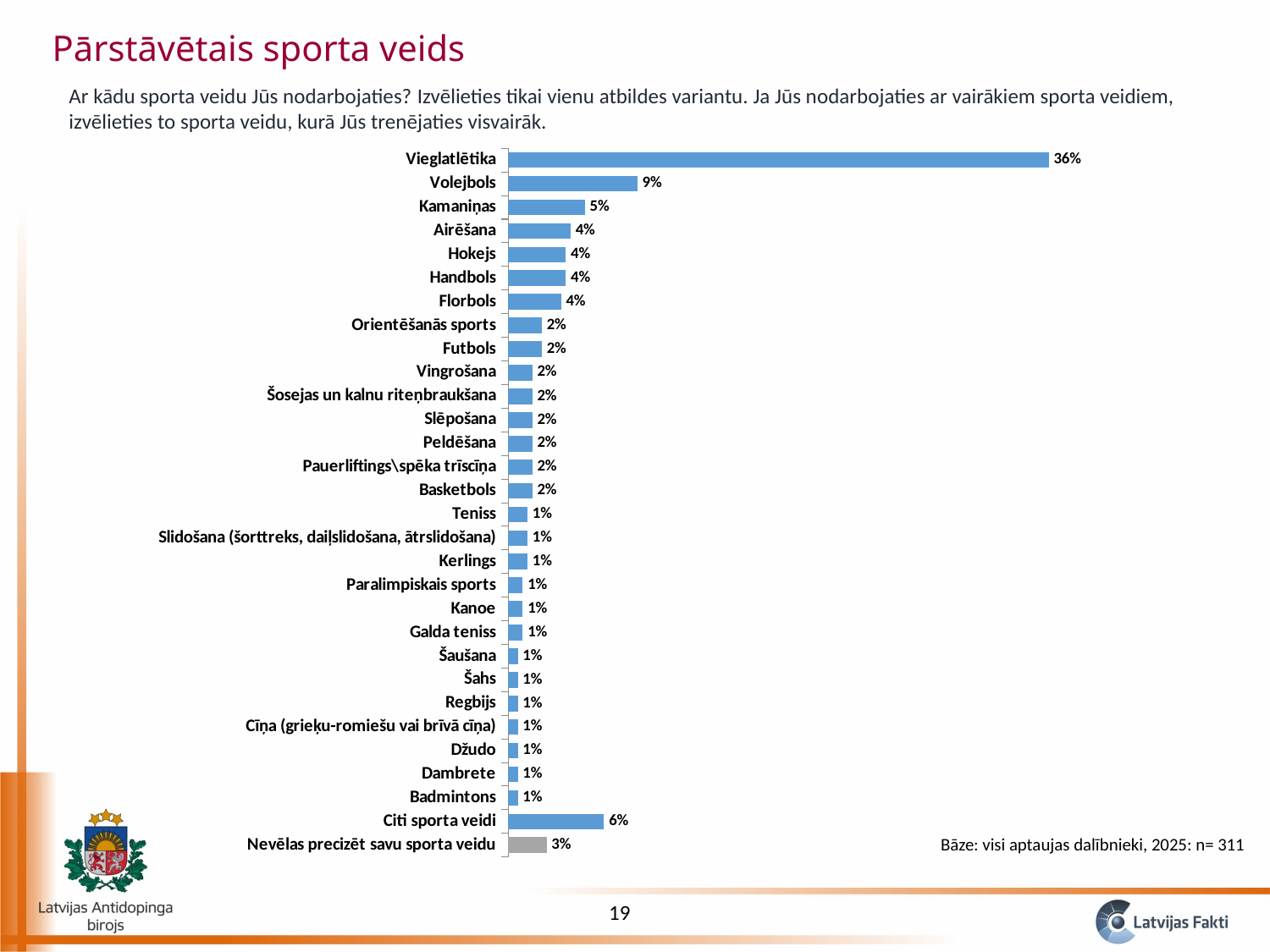
What is the value for Citi sporta veidi? 6% What is the value for Nevēlas precizēt savu sporta veidu? 3% What is the value for Kamaniņas? 5% What kind of chart is shown on the slide? bar chart What is the value for Volejbols? 9% What is the difference between the values for Vieglatlētika and Volejbols? 27 percentage points How many categories are shown in the chart? 30 Which bar is shown in a different colour (grey) from the others? Nevēlas precizēt savu sporta veidu Which is larger, the value for Citi sporta veidi or the value for Nevēlas precizēt savu sporta veidu? Citi sporta veidi Which sport has the highest value? Vieglatlētika What is the value for Vieglatlētika? 36% Which is larger, the value for Volejbols or the value for Kamaniņas? Volejbols